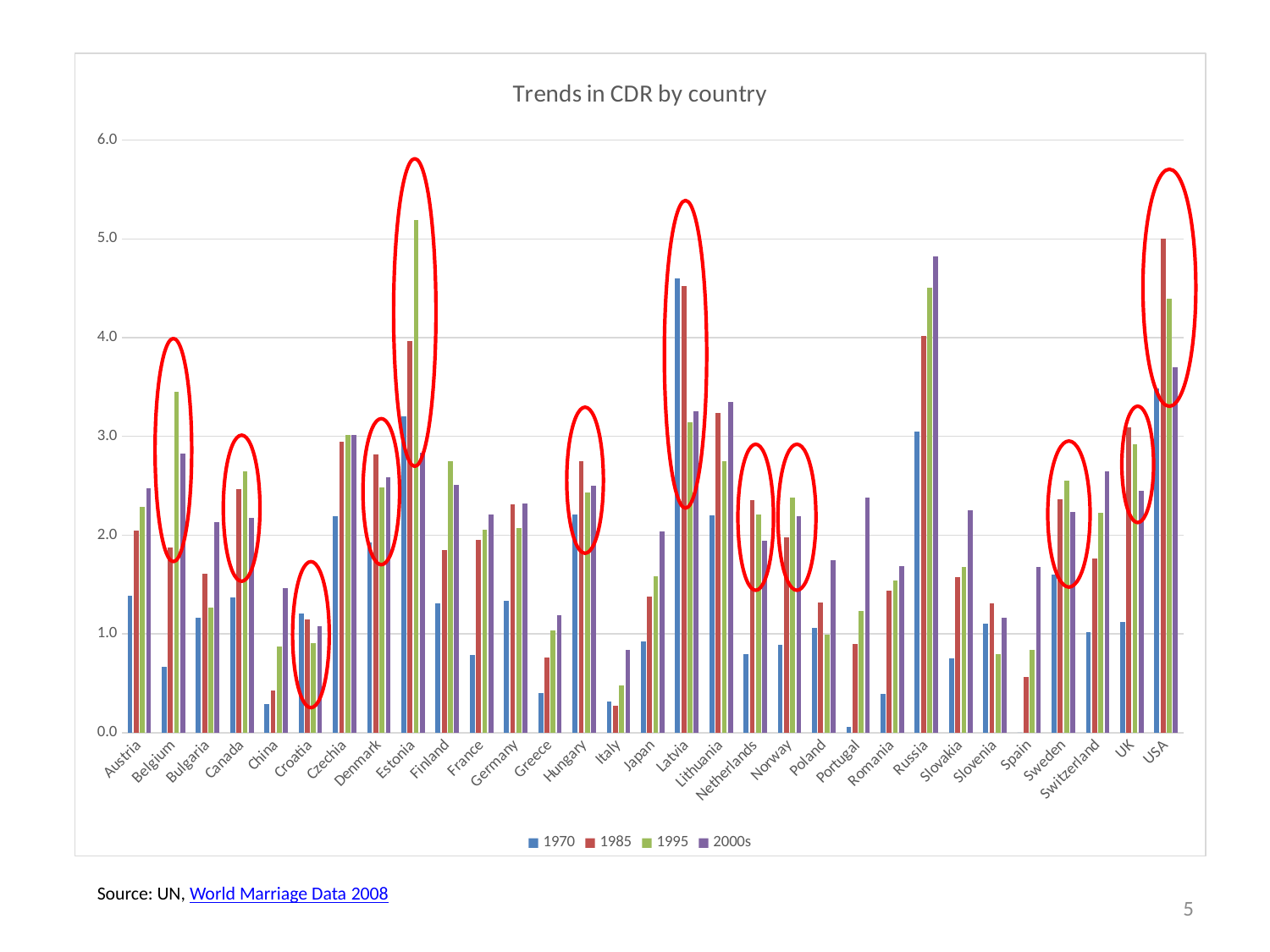
Which country has the highest 2000s value? Russia How many series does the legend list? 4 Which country has the highest 1970 value? Latvia Is the 1970 value for Italy greater or less than 1.0? less Is the 2000s value for Russia greater or less than 4.0? greater Do the values for Russia rise or fall from 1970 to the 2000s? rise What kind of chart is shown on the slide? bar chart Which is larger, the 2000s value for Russia or the 2000s value for the USA? Russia What is the title of the chart? Trends in CDR by country Is the 1995 value for Belgium greater or less than 3.0? greater Which country has the highest 1995 value? Estonia How many countries are shown on the x axis? 31